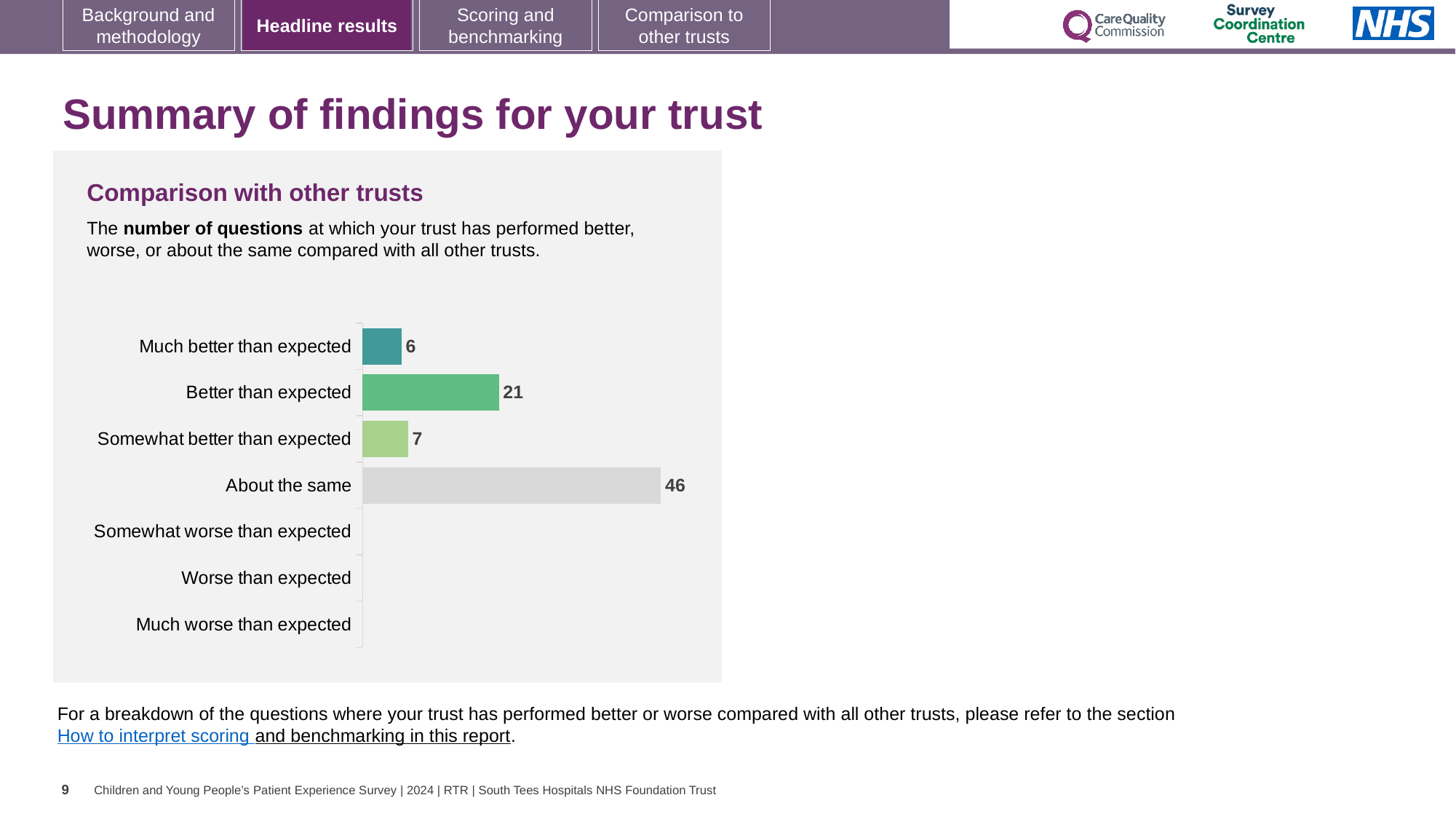
What is the total number of questions across the three 'better than expected' categories? 34 What kind of chart is shown on the slide? Bar chart How many questions were rated 'About the same'? 46 What is the difference between the number of questions rated 'About the same' and 'Better than expected'? 25 How many questions were rated 'Somewhat better than expected'? 7 How many questions were rated 'Better than expected'? 21 Which category has the highest number of questions? About the same How many categories are listed on the chart's axis? 7 What colour is the bar for 'About the same'? Grey How many questions were rated 'Much better than expected'? 6 What is the title of the chart section? Comparison with other trusts Which has more questions: 'Better than expected' or 'Somewhat better than expected'? Better than expected